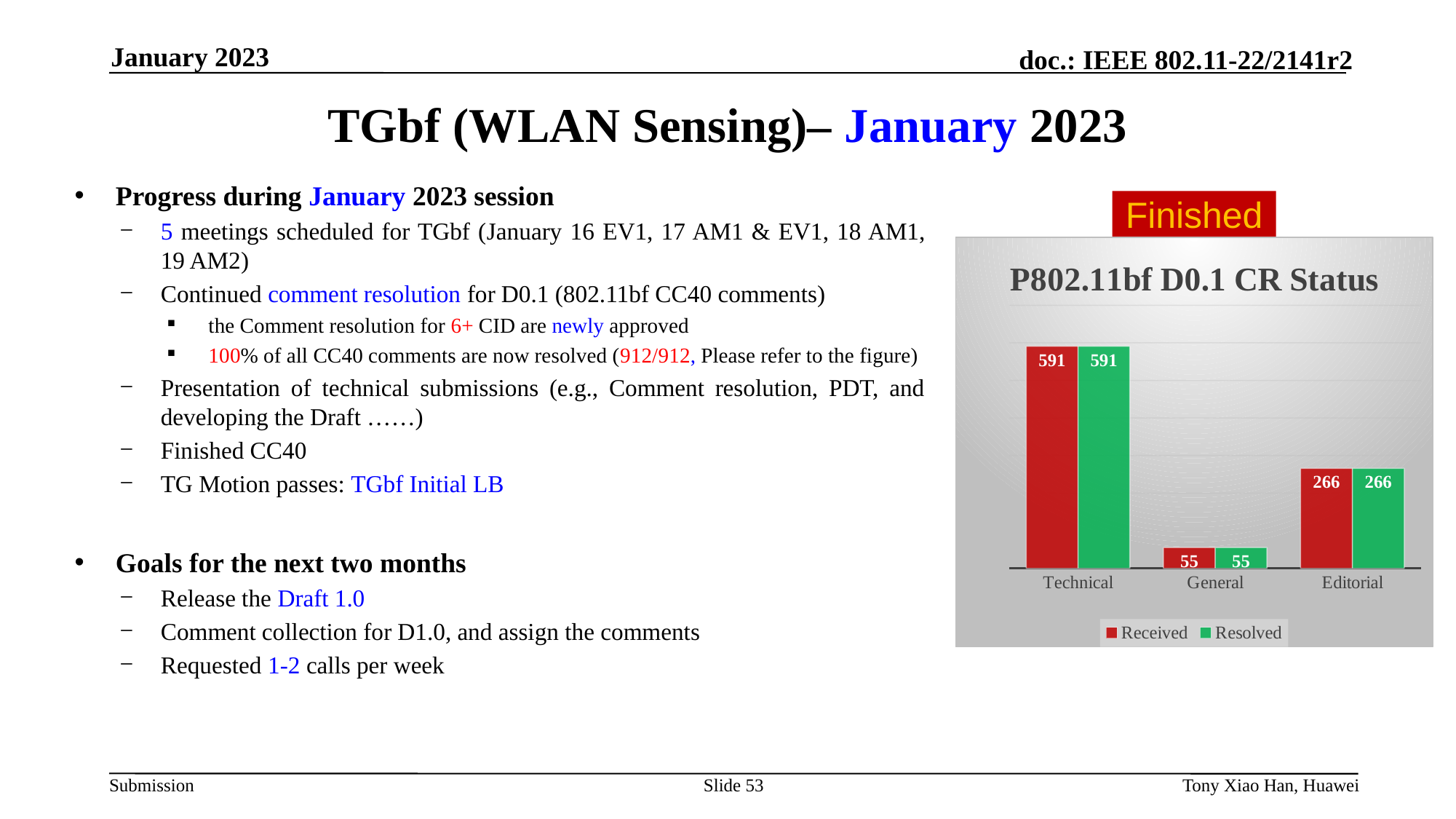
What is the difference between the Received values for Technical and Editorial? 325 How many series does the legend list? 2 What is the Resolved value for General? 55 What is the Received value for Editorial? 266 Which is larger, the Received value for General or the Received value for Editorial? Editorial What is the difference between the Resolved values for Editorial and General? 211 Which category has the lowest Resolved value? General What is the Received value for Technical? 591 What kind of chart is shown? Bar chart How many categories are shown on the x axis? 3 What is the title of the chart? P802.11bf D0.1 CR Status Which category has the highest Received value? Technical